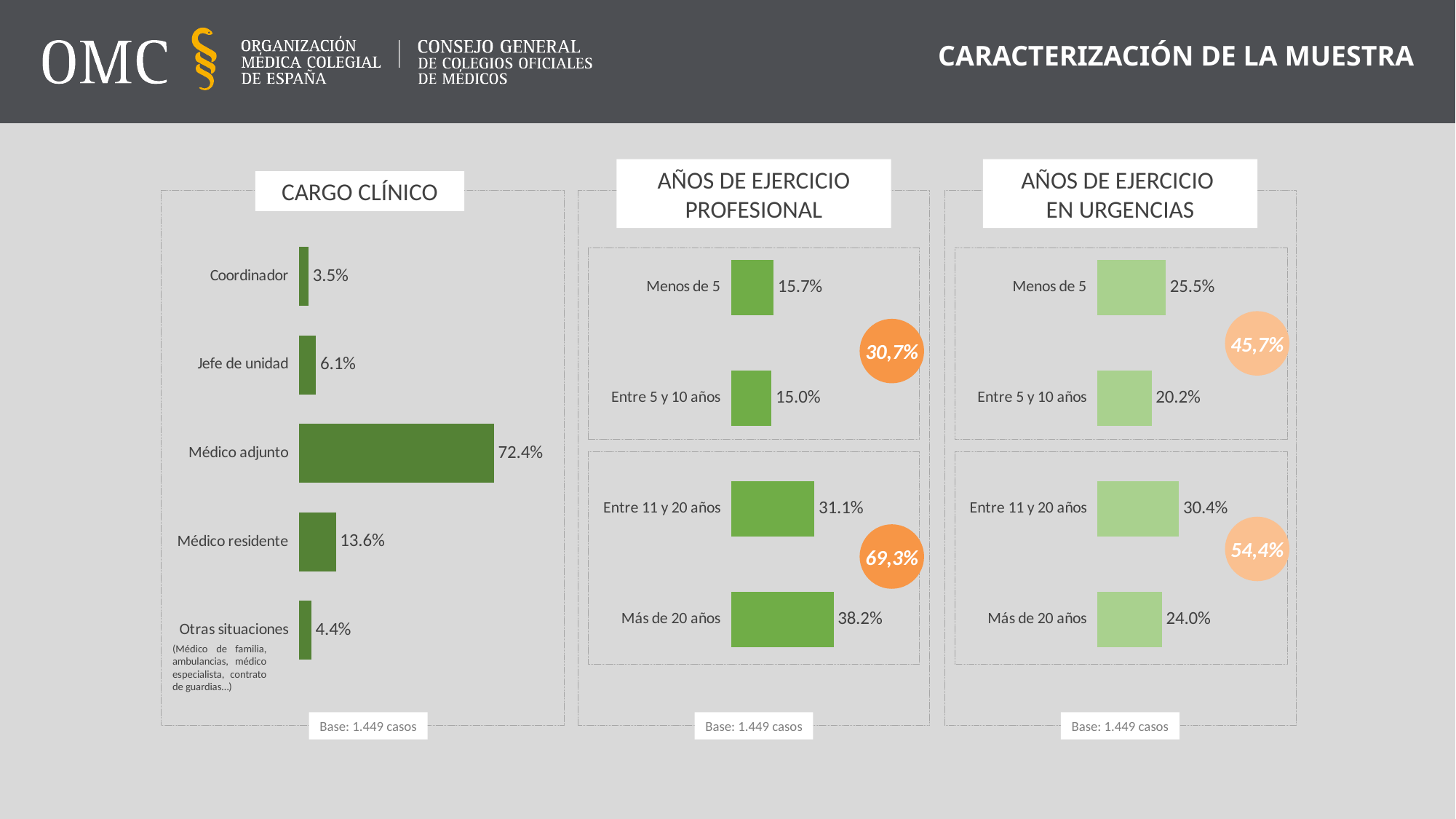
In the AÑOS DE EJERCICIO EN URGENCIAS chart, what is the value for Entre 5 y 10 años? 20.2% In the AÑOS DE EJERCICIO PROFESIONAL chart, which category has the highest value? Más de 20 años In the AÑOS DE EJERCICIO EN URGENCIAS chart, which is larger, Menos de 5 or Más de 20 años? Menos de 5 How many categories does the CARGO CLÍNICO chart show? 5 In the CARGO CLÍNICO chart, which category has the lowest value? Coordinador In the CARGO CLÍNICO chart, what is the difference between Médico residente and Jefe de unidad? 7.5% What base (number of cases) is stated under each chart? Base: 1.449 casos In the AÑOS DE EJERCICIO EN URGENCIAS chart, what is the difference between Entre 11 y 20 años and Más de 20 años? 6.4% In the AÑOS DE EJERCICIO PROFESIONAL chart, what is the value for Más de 20 años? 38.2% In the CARGO CLÍNICO chart, what is the value for Médico adjunto? 72.4% What kind of chart is the CARGO CLÍNICO chart? Bar chart In the AÑOS DE EJERCICIO PROFESIONAL chart, what is the combined share shown for Entre 11 y 20 años and Más de 20 años? 69,3%